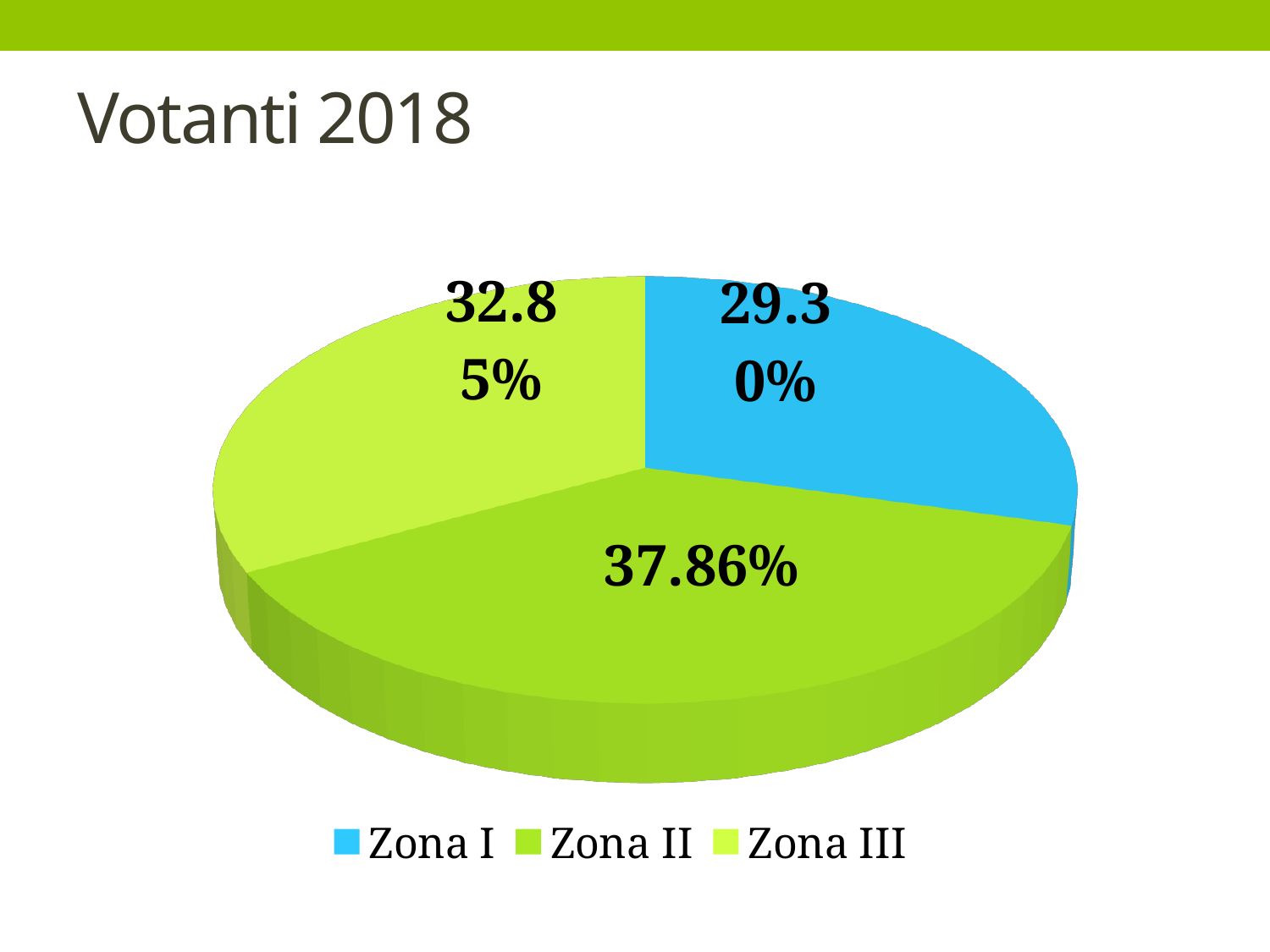
How many categories does the legend list? 3 What is the slide title? Votanti 2018 Which zone has the largest share of the pie? Zona II Which zone has the smallest share of the pie? Zona I What percentage is shown for Zona III? 32.85% Which colour represents Zona I in the chart? blue What is the difference between the shares of Zona II and Zona I? 8.56% What percentage is shown for Zona II? 37.86% What kind of chart is shown on the slide? pie chart What is the difference between the shares of Zona III and Zona I? 3.55% What percentage is shown for Zona I? 29.30% Which is larger, the share for Zona III or the share for Zona I? Zona III